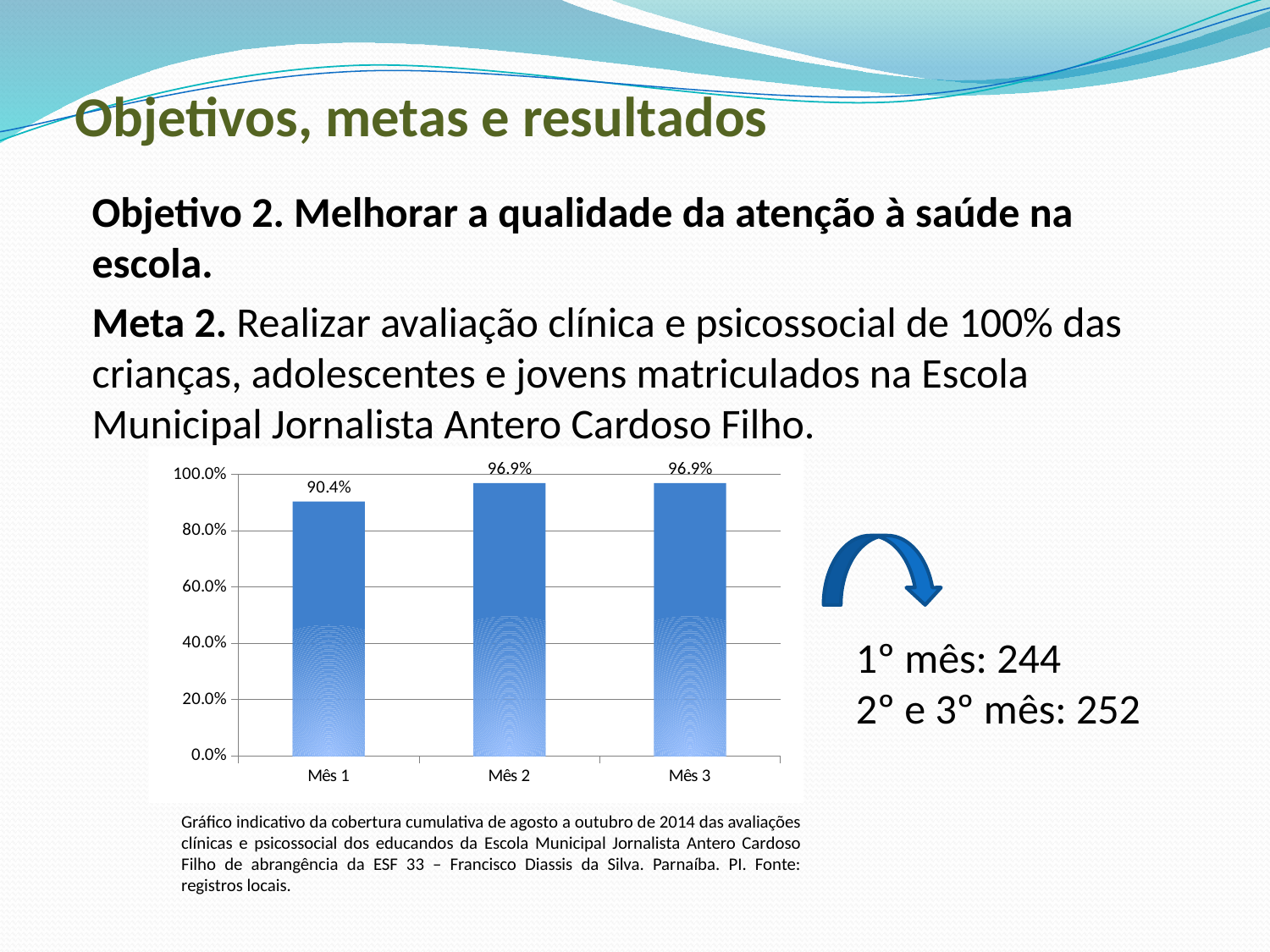
What is the value for Mês 2? 96.9% What is the highest tick value shown on the y axis? 100.0% What is the value for Mês 1? 90.4% Which month has the lowest value? Mês 1 What is the value for Mês 3? 96.9% Which is larger, the value for Mês 1 or the value for Mês 3? Mês 3 How many categories are shown on the x axis? 3 Is the value for Mês 1 greater or less than 80.0%? greater What is the difference between the values for Mês 2 and Mês 1? 6.5% Do the values rise or fall from Mês 1 to Mês 2? rise What kind of chart is shown on the slide? bar chart Do the values for Mês 2 and Mês 3 differ? No, both are 96.9%